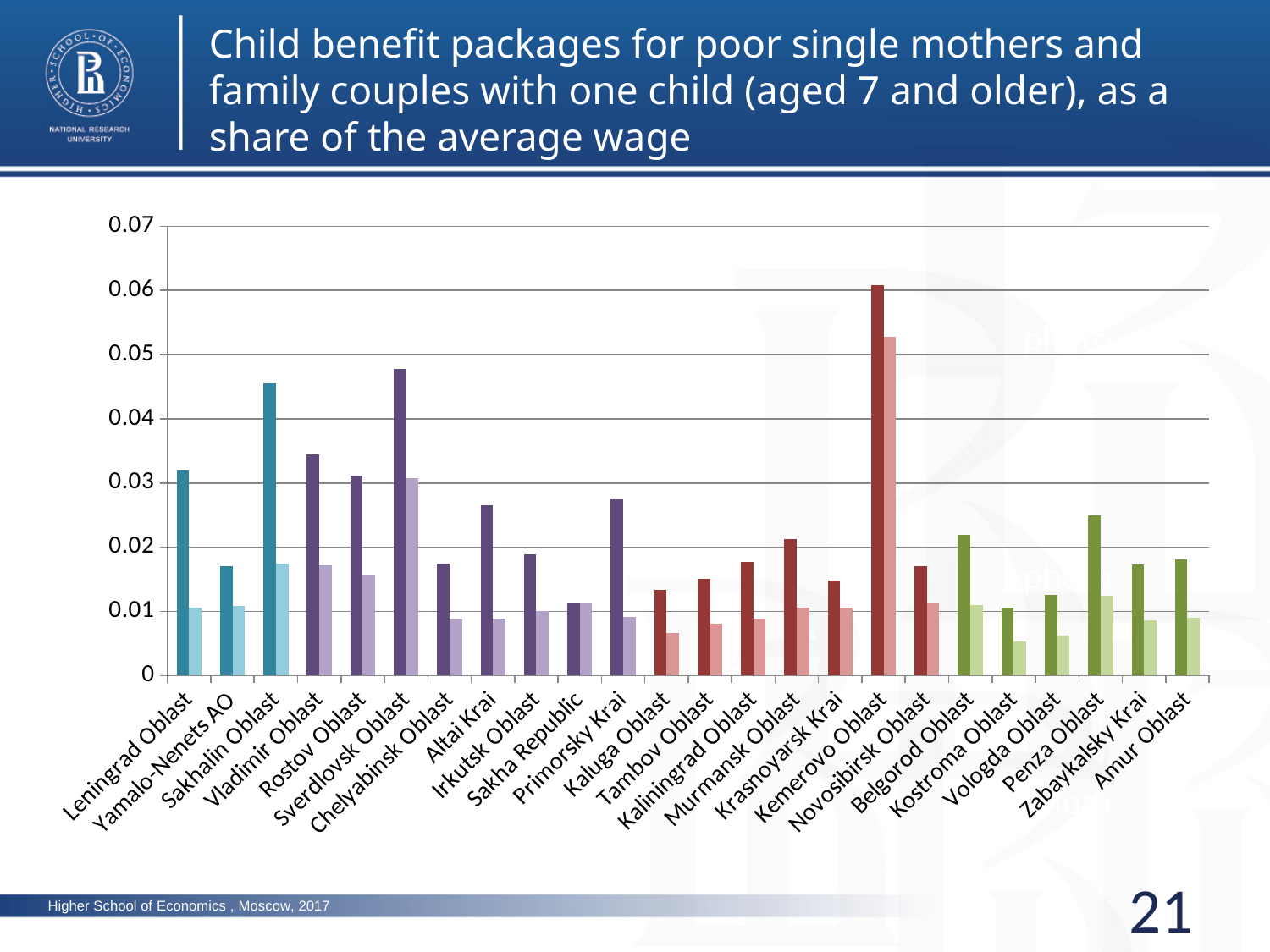
Is the value of the darker bar for Sakhalin Oblast greater or less than 0.04? greater Which has the taller darker bar, Sakhalin Oblast or Vladimir Oblast? Sakhalin Oblast How many regions are shown along the x axis of the chart? 24 Which region has the tallest bar in the chart? Kemerovo Oblast Is the value of the darker bar for Altai Krai greater or less than 0.03? less Is the value of the darker bar for Kaluga Oblast greater or less than 0.02? less What kind of chart is shown on the slide? bar chart Which has the taller darker bar, Kemerovo Oblast or Sverdlovsk Oblast? Kemerovo Oblast How many bars are plotted for each region in the chart? 2 Which has the taller darker bar, Primorsky Krai or Kaluga Oblast? Primorsky Krai